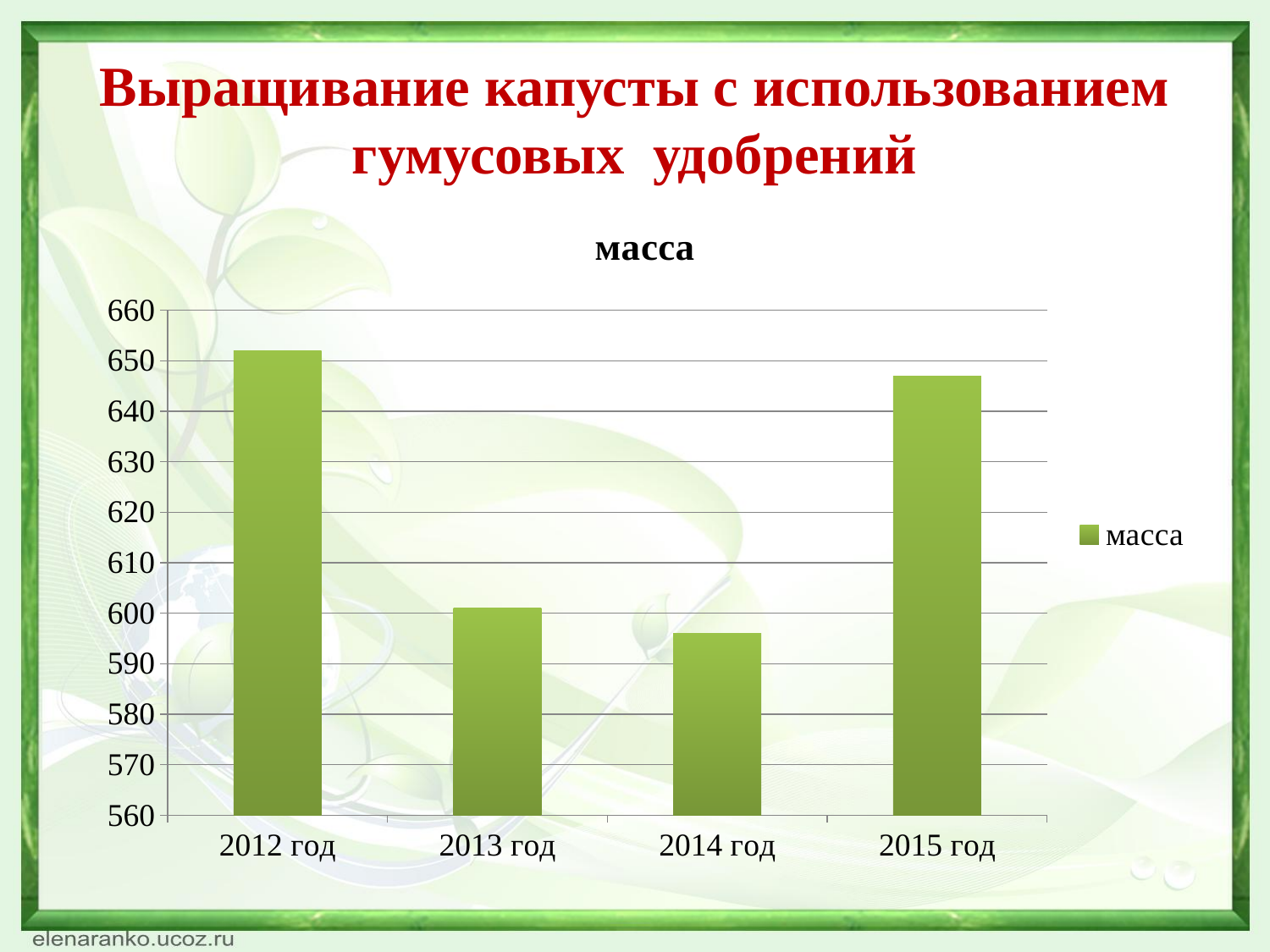
Which year has the highest value? 2012 год Is the value for 2015 год greater or less than 640? greater Which is larger, the value for 2013 год or the value for 2015 год? 2015 год What kind of chart is shown on the slide? bar chart Is the value for 2013 год greater or less than 610? less What is the title of the chart? масса How many categories (years) are shown on the x axis? 4 What is the name of the series shown in the legend? масса Is the value for 2014 год greater or less than 600? less Which year has the lowest value? 2014 год How many series does the legend list? 1